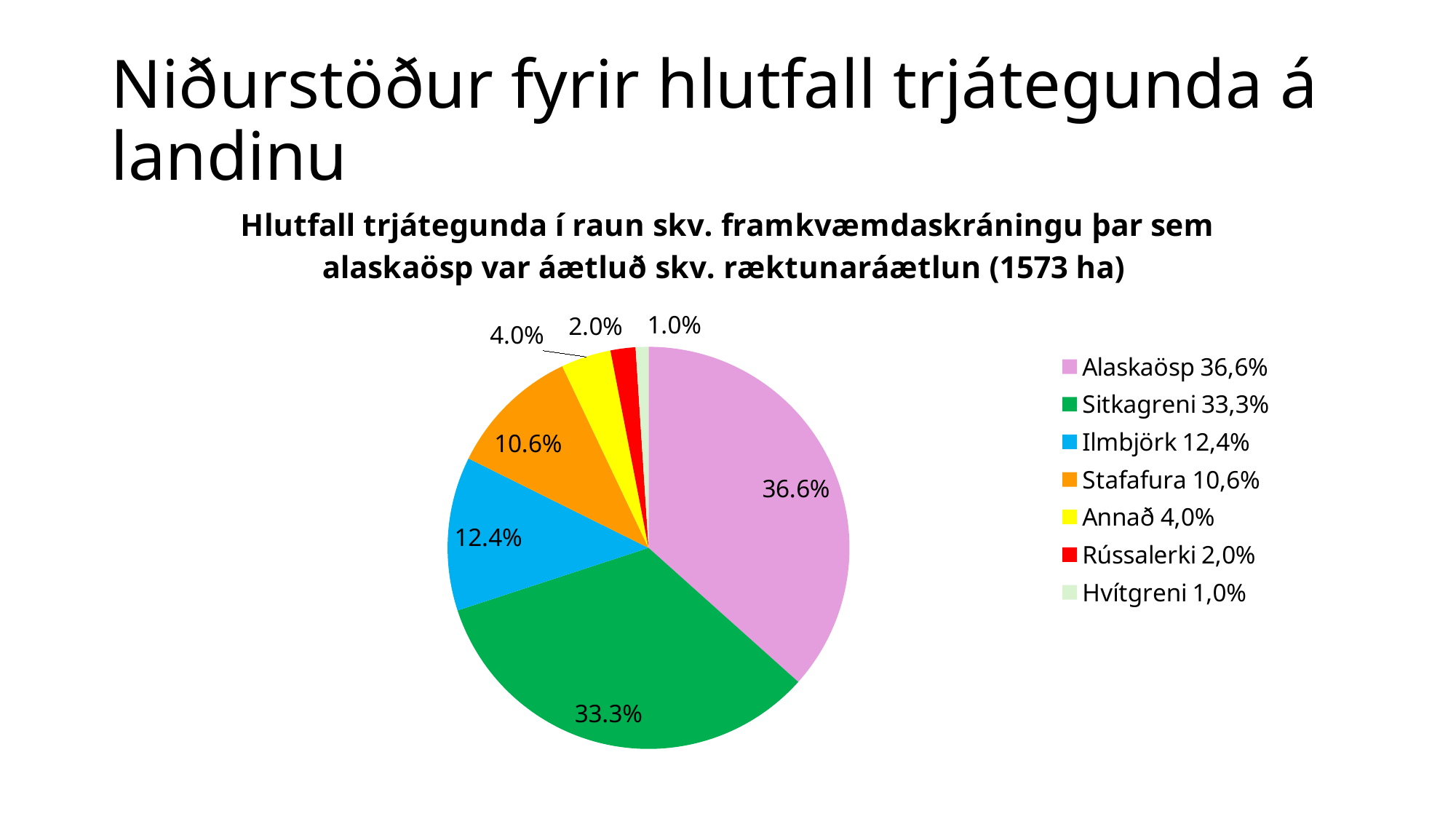
What share of the pie does Stafafura have? 10.6% Which tree species has the largest slice of the pie? Alaskaösp What is the difference in percentage points between Alaskaösp and Sitkagreni? 3.3 Which has a larger share, Ilmbjörk or Annað? Ilmbjörk What share of the pie does Rússalerki have? 2.0% What kind of chart is shown on the slide? Pie chart What share of the pie does Sitkagreni have? 33.3% What colour is the slice for Sitkagreni? Green What share of the pie does Alaskaösp have? 36.6% How many slices does the pie chart have? 7 What is the difference in percentage points between Ilmbjörk and Stafafura? 1.8 Which tree species has the smallest slice of the pie? Hvítgreni